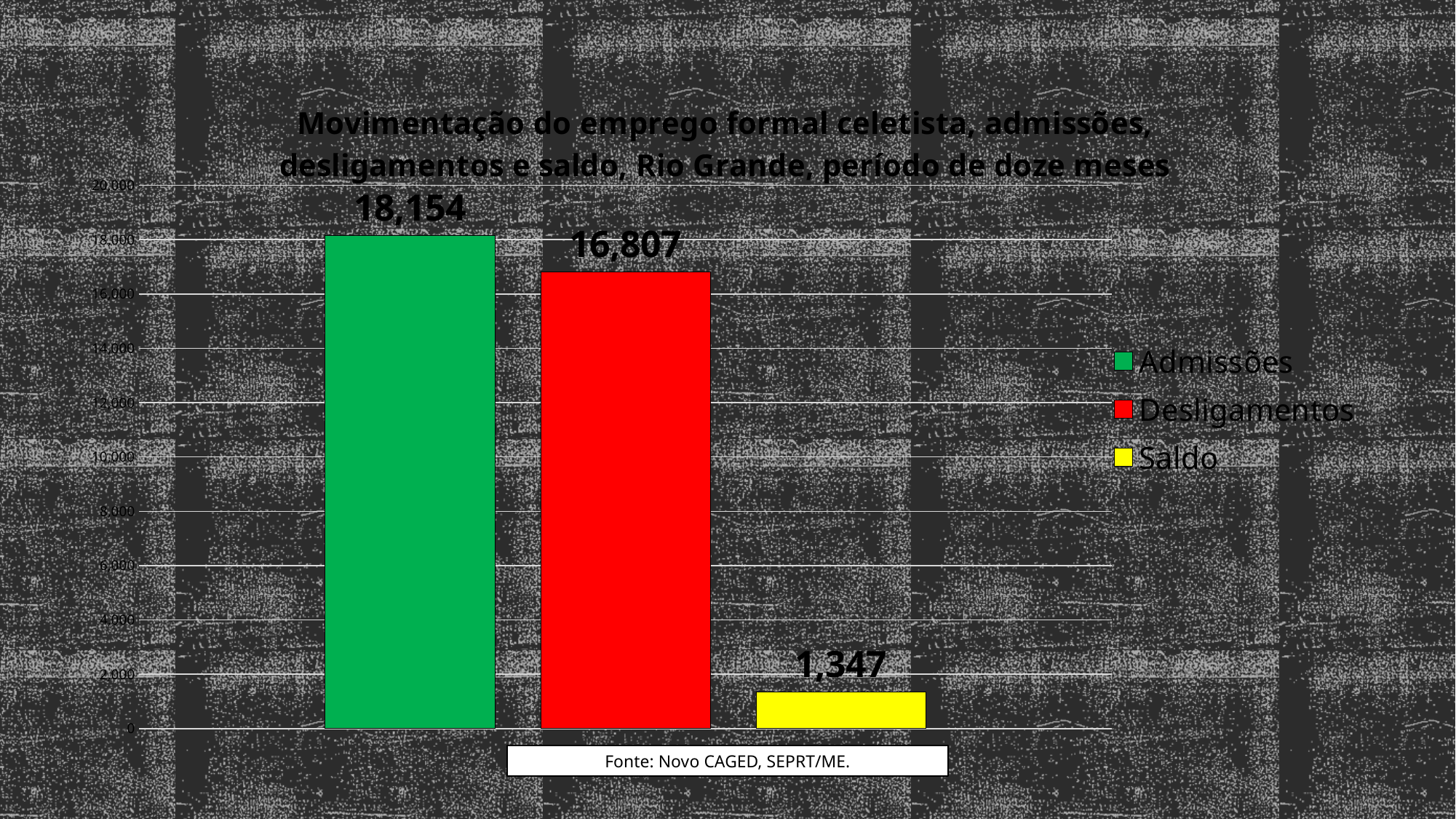
How many bars are plotted on the chart? 3 What is the value for Admissões? 18,154 What is the difference between Admissões and Desligamentos? 1,347 What is the value for Desligamentos? 16,807 What colour is the Saldo bar? yellow How many series does the legend list? 3 Which series has the lowest value? Saldo Which is larger, Admissões or Desligamentos? Admissões What is the value for Saldo? 1,347 What kind of chart is shown? bar chart Is the value for Saldo greater or less than 2,000? less Which series has the highest value? Admissões